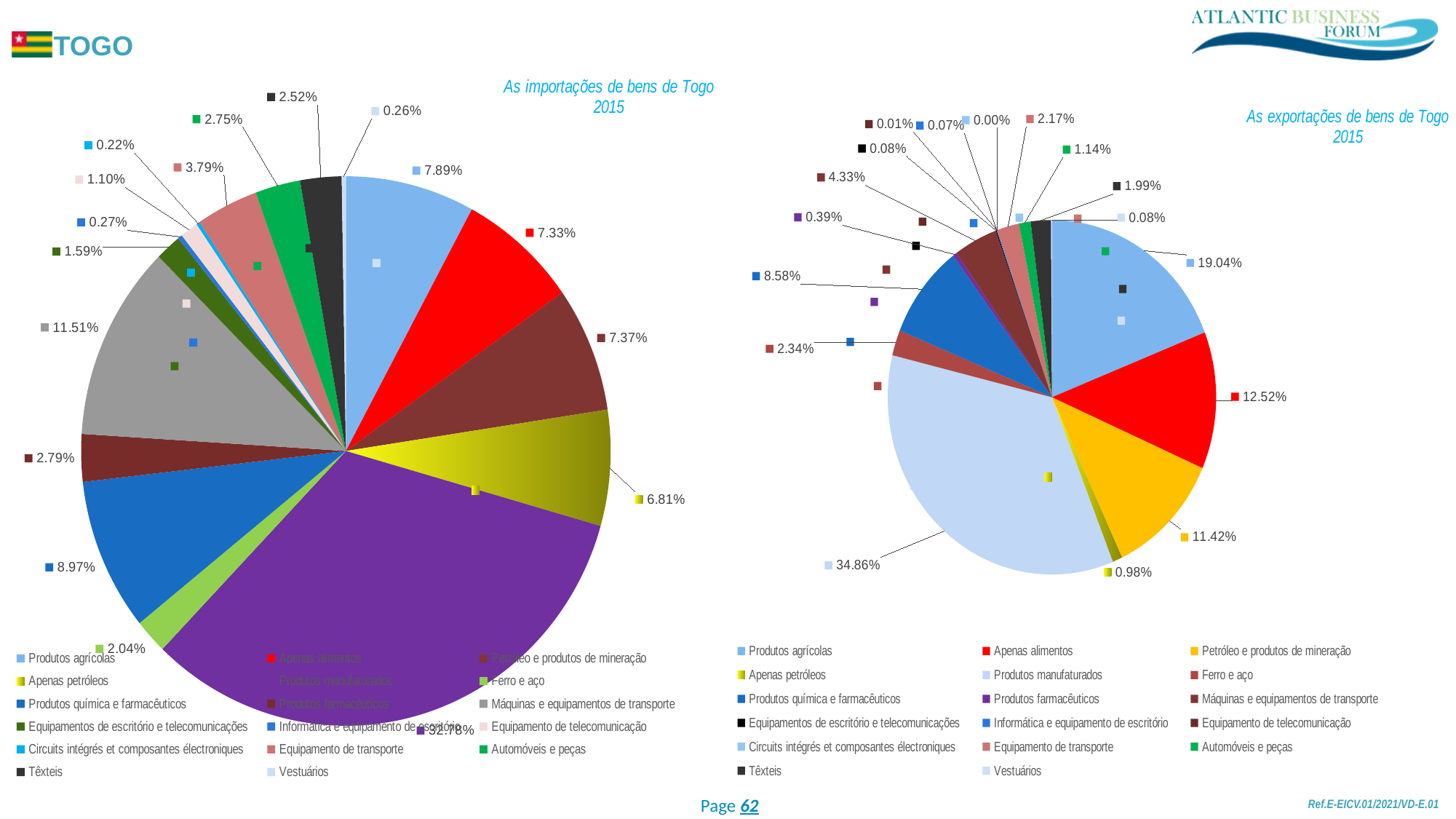
In the chart 'As exportações de bens de Togo 2015', what is the difference between the shares of Produtos agrícolas (19.04%) and Apenas alimentos (12.52%)? 6.52% In the chart 'As exportações de bens de Togo 2015', what share do Produtos agrícolas have? 19.04% In the chart 'As importações de bens de Togo 2015', which is larger: the share of Produtos agrícolas or the share of Apenas petróleos? Produtos agrícolas In the chart 'As exportações de bens de Togo 2015', which category has the largest share? Produtos manufaturados In the chart 'As importações de bens de Togo 2015', which category has the largest share? Produtos manufaturados In the chart 'As importações de bens de Togo 2015', what share do Máquinas e equipamentos de transporte have? 11.51% In the chart 'As importações de bens de Togo 2015', what is the share for Produtos química e farmacêuticos? 8.97% What colour is the Produtos manufaturados slice in the chart 'As importações de bens de Togo 2015'? purple In the chart 'As exportações de bens de Togo 2015', what is the share for Petróleo e produtos de mineração? 11.42% How many entries does the legend of the chart 'As exportações de bens de Togo 2015' list? 17 In the chart 'As exportações de bens de Togo 2015', what is the share for Apenas alimentos? 12.52% What type of chart is used for 'As importações de bens de Togo 2015'? pie chart